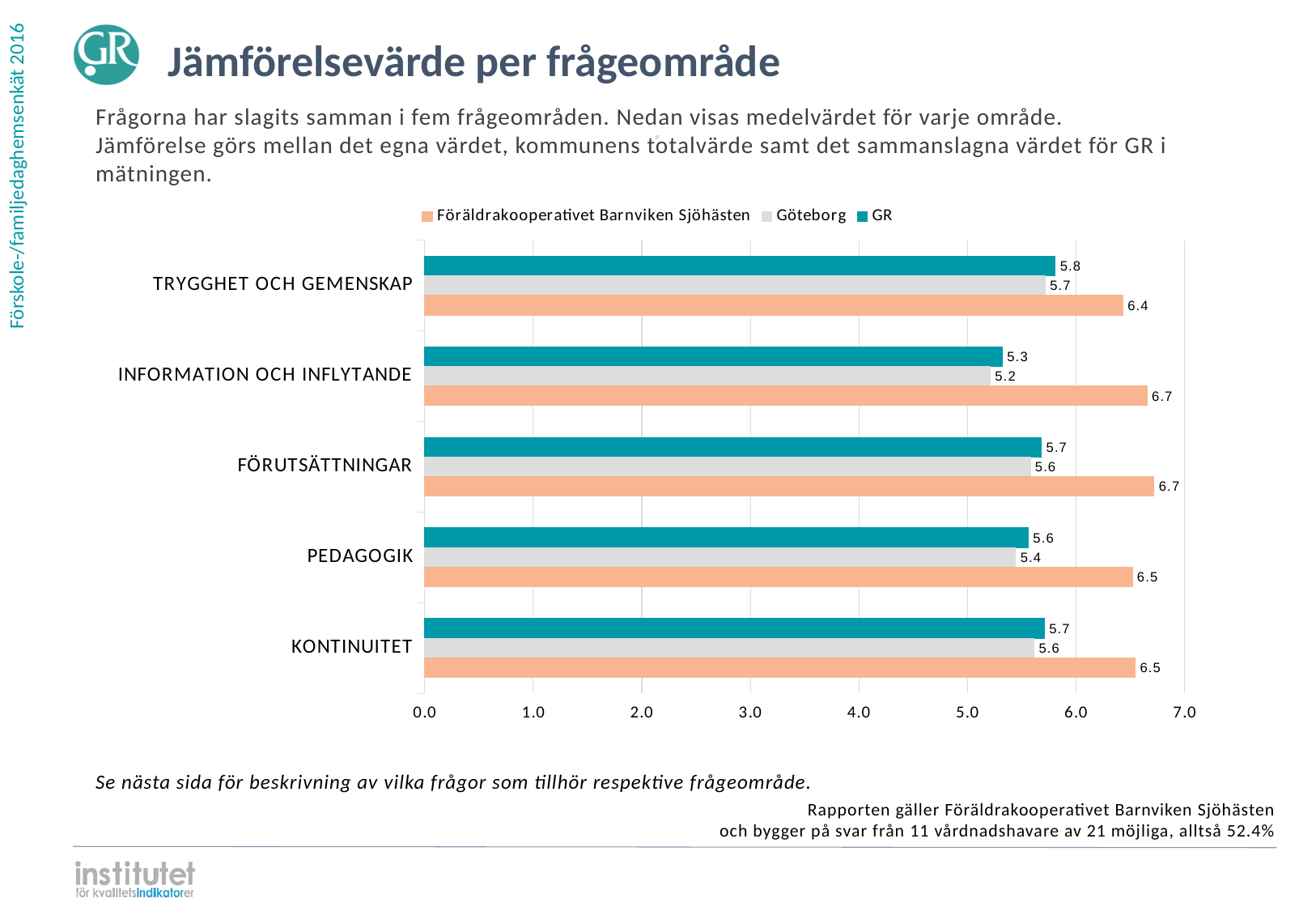
Which is larger in the PEDAGOGIK category: the value for GR or the value for Göteborg? GR What kind of chart is shown on the slide? Bar chart What is the difference between the Föräldrakooperativet Barnviken Sjöhästen value and the Göteborg value in the INFORMATION OCH INFLYTANDE category? 1.5 What is the value for Göteborg in the PEDAGOGIK category? 5.4 What is the value for GR in the INFORMATION OCH INFLYTANDE category? 5.3 Which series is shown in orange in the legend? Föräldrakooperativet Barnviken Sjöhästen Is the value for Föräldrakooperativet Barnviken Sjöhästen in the KONTINUITET category greater or less than 6.0? greater What is the value for Föräldrakooperativet Barnviken Sjöhästen in the TRYGGHET OCH GEMENSKAP category? 6.4 How many series does the legend list? 3 How many categories (frågeområden) are shown on the chart? 5 In which category does Göteborg have its lowest value? INFORMATION OCH INFLYTANDE In which category does GR have its highest value? TRYGGHET OCH GEMENSKAP